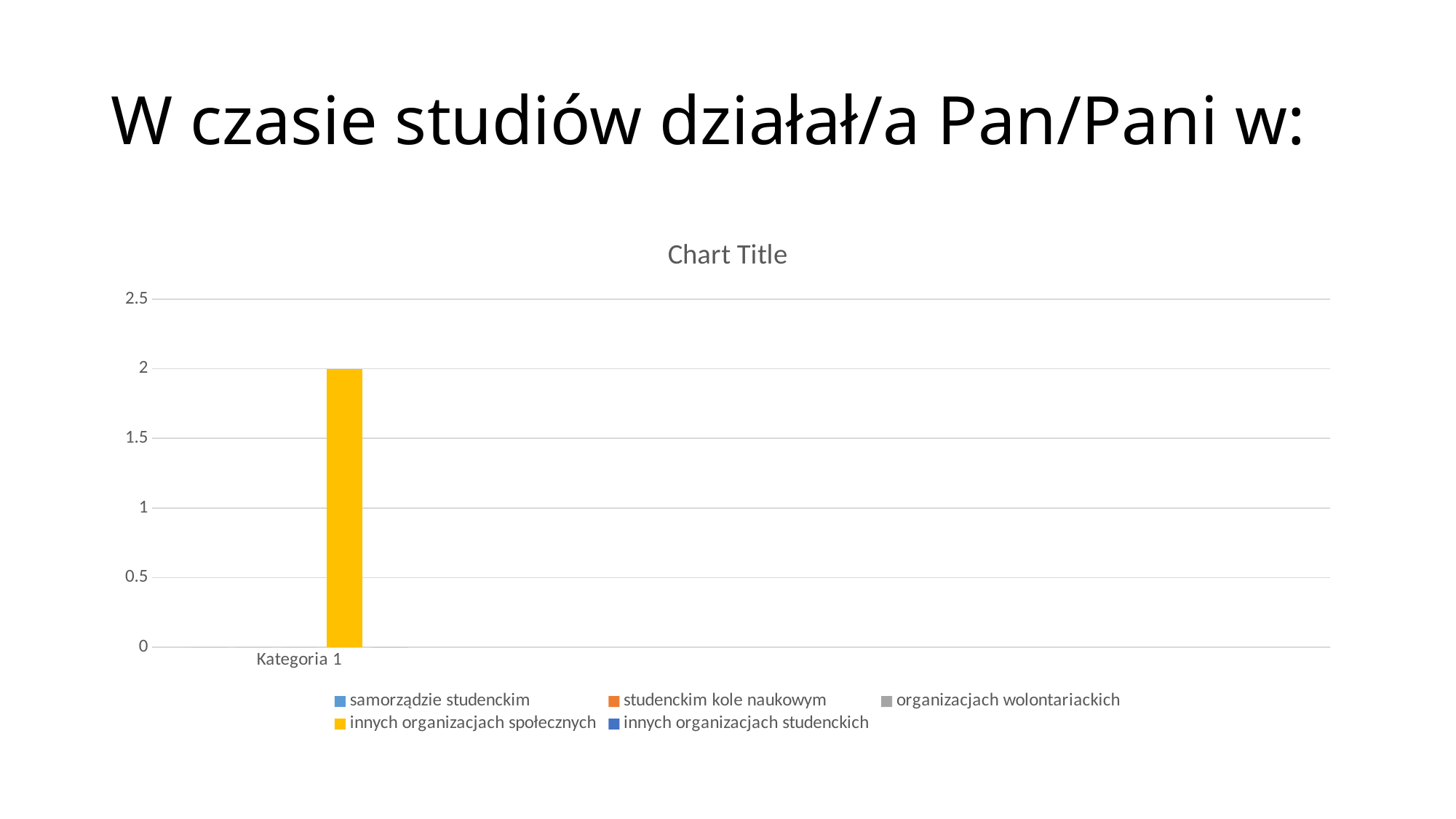
What kind of chart is shown on the slide? bar chart What is the value for 'innych organizacjach społecznych' in Kategoria 1? 2 What is the title of the chart? Chart Title Which series has the highest value in Kategoria 1? innych organizacjach społecznych Is the value for 'innych organizacjach społecznych' greater or less than 2.5? less Is the value for 'innych organizacjach społecznych' greater or less than 1.5? greater What is the name of the category on the x axis? Kategoria 1 How many series does the legend list? 5 What is the highest value shown on the vertical axis? 2.5 How many categories are shown on the x axis? 1